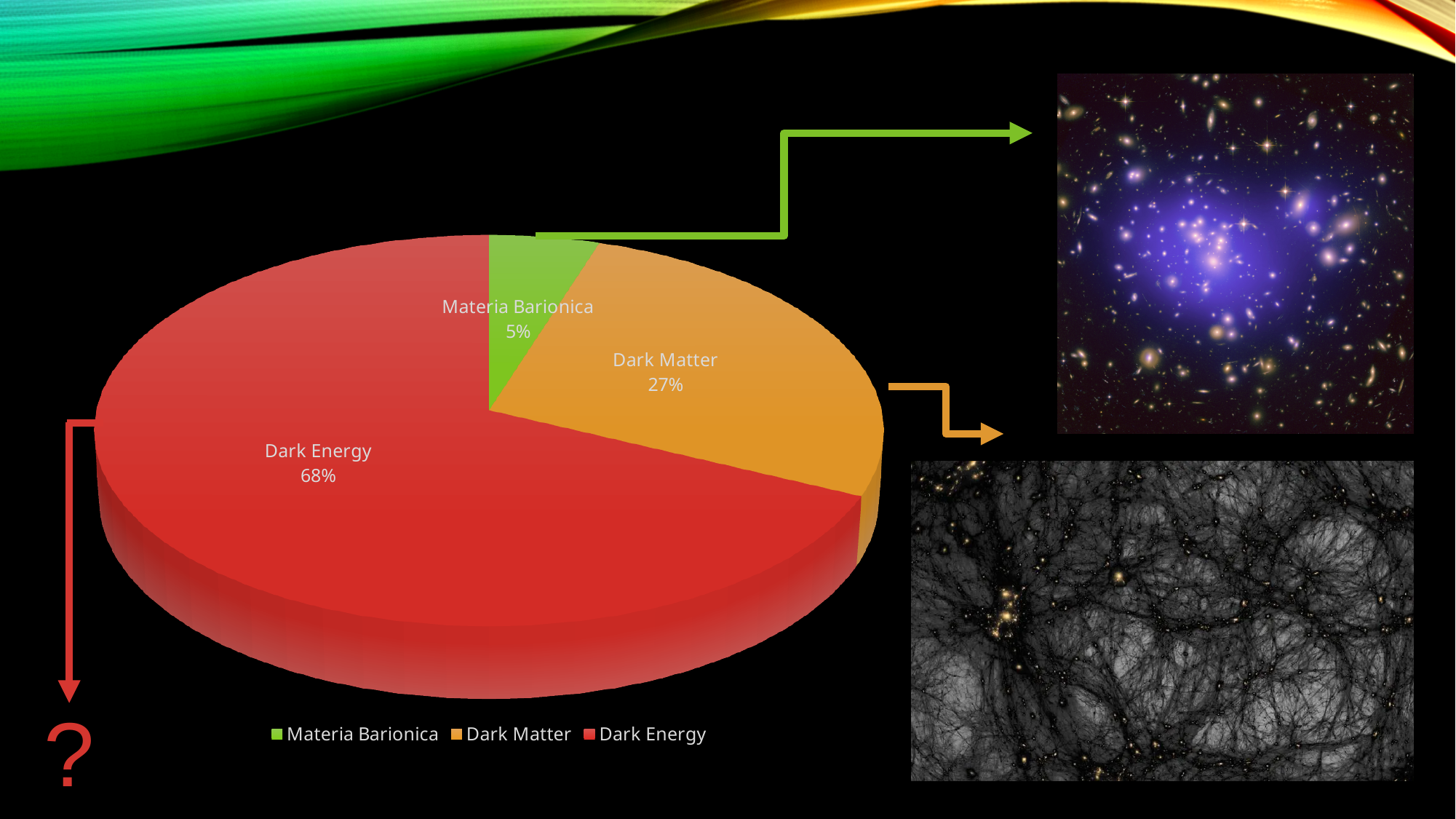
What kind of chart is shown on the slide? Pie chart Which slice of the pie is the largest? Dark Energy What percentage does the Dark Energy slice show? 68% What percentage does the Dark Matter slice show? 27% Which is larger, the Dark Matter slice or the Materia Barionica slice? Dark Matter What colour is the Dark Matter slice in the pie chart? Orange How many slices does the pie chart have? 3 How many entries does the legend list? 3 Which slice of the pie is the smallest? Materia Barionica What is the difference in percentage points between Dark Matter and Materia Barionica? 22 What is the difference in percentage points between Dark Energy and Dark Matter? 41 What percentage does the Materia Barionica slice show? 5%